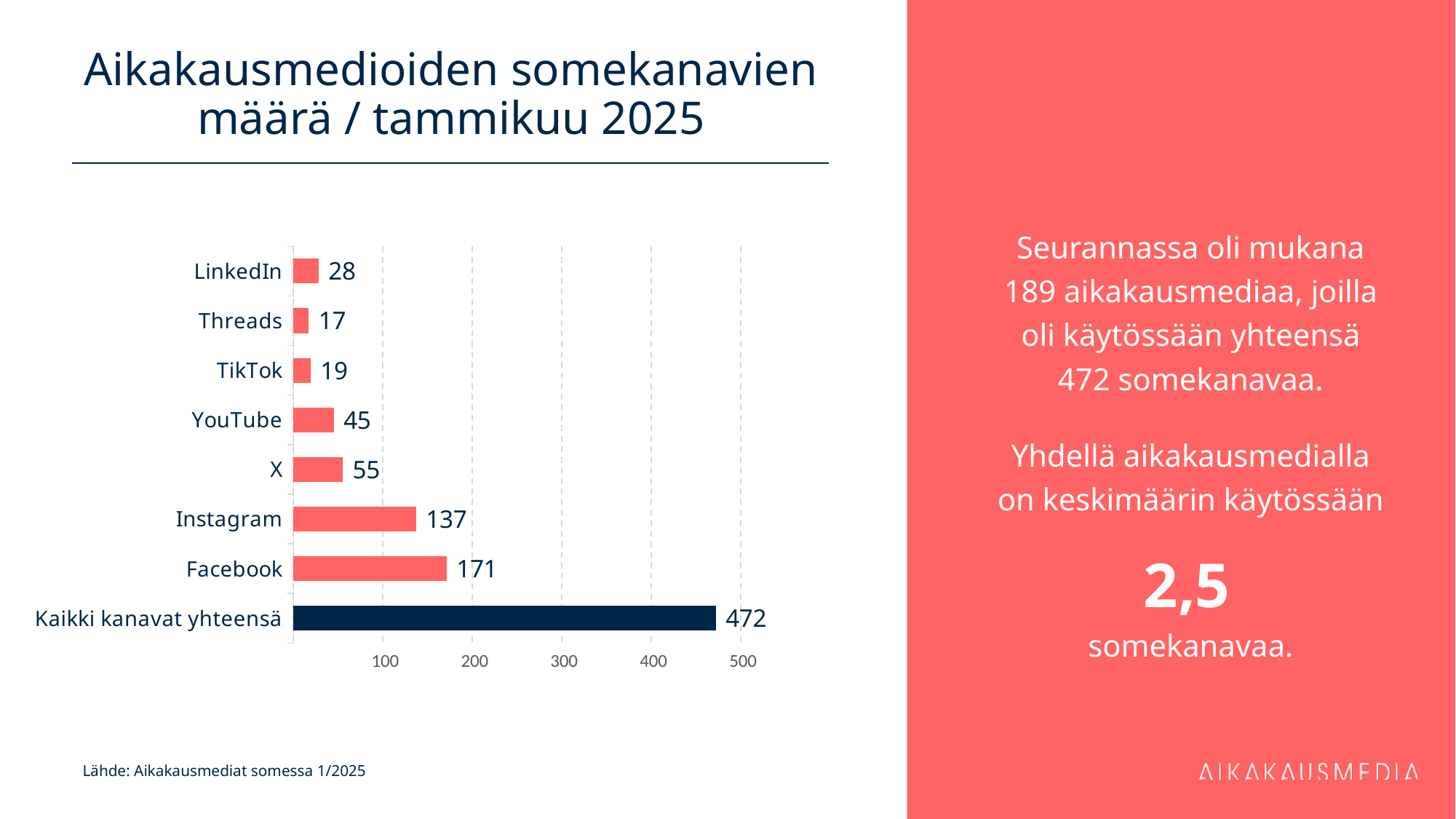
Which category has the lowest value? Threads What kind of chart is shown on the slide? bar chart Which is larger, the value for X or the value for YouTube? X What is the difference between the values for Facebook and Instagram? 34 Is the value for Instagram greater or less than 100? greater How many categories are shown on the chart? 8 What is the value for Threads? 17 What is the value for Kaikki kanavat yhteensä? 472 Which individual channel (excluding the total bar) has the highest value? Facebook What is the value for Instagram? 137 What is the title of the chart on the slide? Aikakausmedioiden somekanavien määrä / tammikuu 2025 What is the value for Facebook? 171